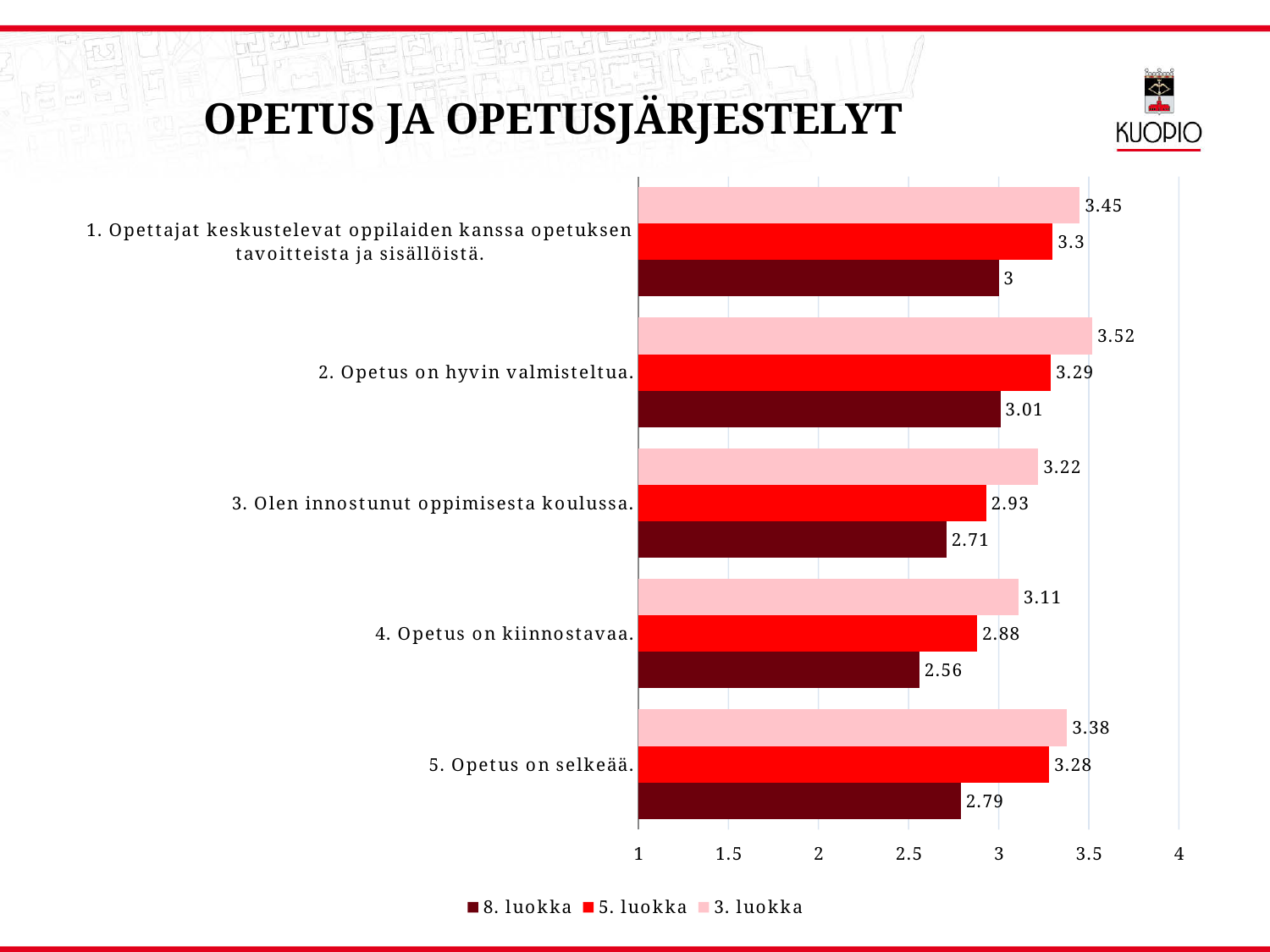
For "1. Opettajat keskustelevat oppilaiden kanssa opetuksen tavoitteista ja sisällöistä.", which is larger: the 5. luokka value or the 8. luokka value? 5. luokka What is the value for 8. luokka for "4. Opetus on kiinnostavaa."? 2.56 Which statement has the lowest value for 8. luokka? 4. Opetus on kiinnostavaa. What is the value for 5. luokka for "5. Opetus on selkeää."? 3.28 How many series does the legend list? 3 How many categories (statements) are shown on the chart? 5 Which statement has the highest value for 3. luokka? 2. Opetus on hyvin valmisteltua. What is the value for 3. luokka for "2. Opetus on hyvin valmisteltua."? 3.52 Is the 8. luokka value for "5. Opetus on selkeää." greater or less than 3? less What is the title of the slide? OPETUS JA OPETUSJÄRJESTELYT What type of chart is shown on the slide? bar chart What is the difference between the 3. luokka and 8. luokka values for "3. Olen innostunut oppimisesta koulussa."? 0.51